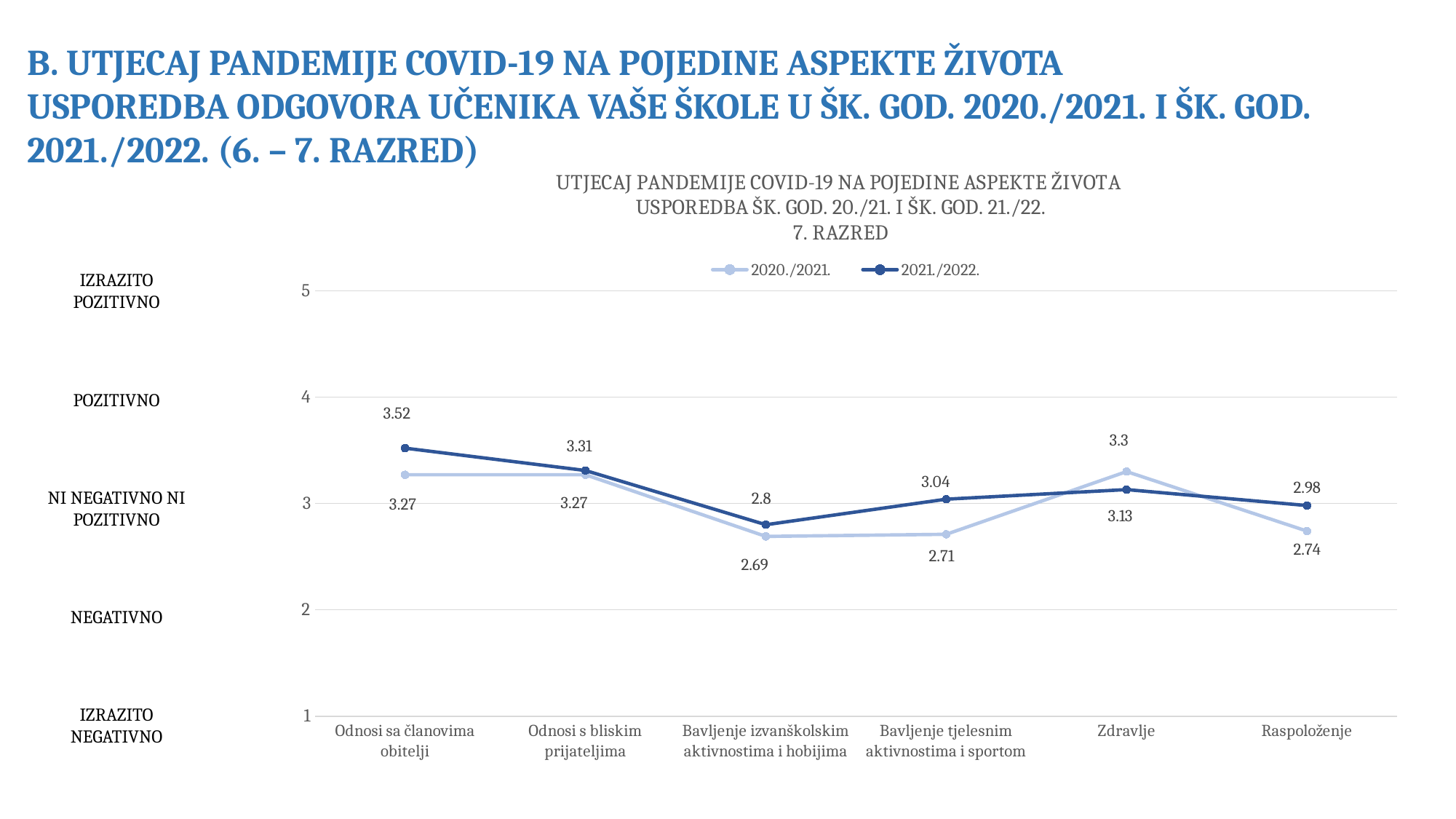
For Zdravlje, which series has the larger value, 2020./2021. or 2021./2022.? 2020./2021. How many series does the legend list? 2 What is the value for Bavljenje tjelesnim aktivnostima i sportom in the 2021./2022. series? 3.04 Is the 2021./2022. value for Bavljenje izvanškolskim aktivnostima i hobijima greater or less than 3? less What is the difference between the 2021./2022. and 2020./2021. values for Bavljenje tjelesnim aktivnostima i sportom? 0.33 Which category has the lowest value in the 2020./2021. series? Bavljenje izvanškolskim aktivnostima i hobijima Which category has the highest value in the 2021./2022. series? Odnosi sa članovima obitelji What is the value for Raspoloženje in the 2020./2021. series? 2.74 What is the value for Zdravlje in the 2020./2021. series? 3.3 What kind of chart is shown on the slide? line chart What is the value for Odnosi sa članovima obitelji in the 2021./2022. series? 3.52 How many categories are shown on the x axis? 6